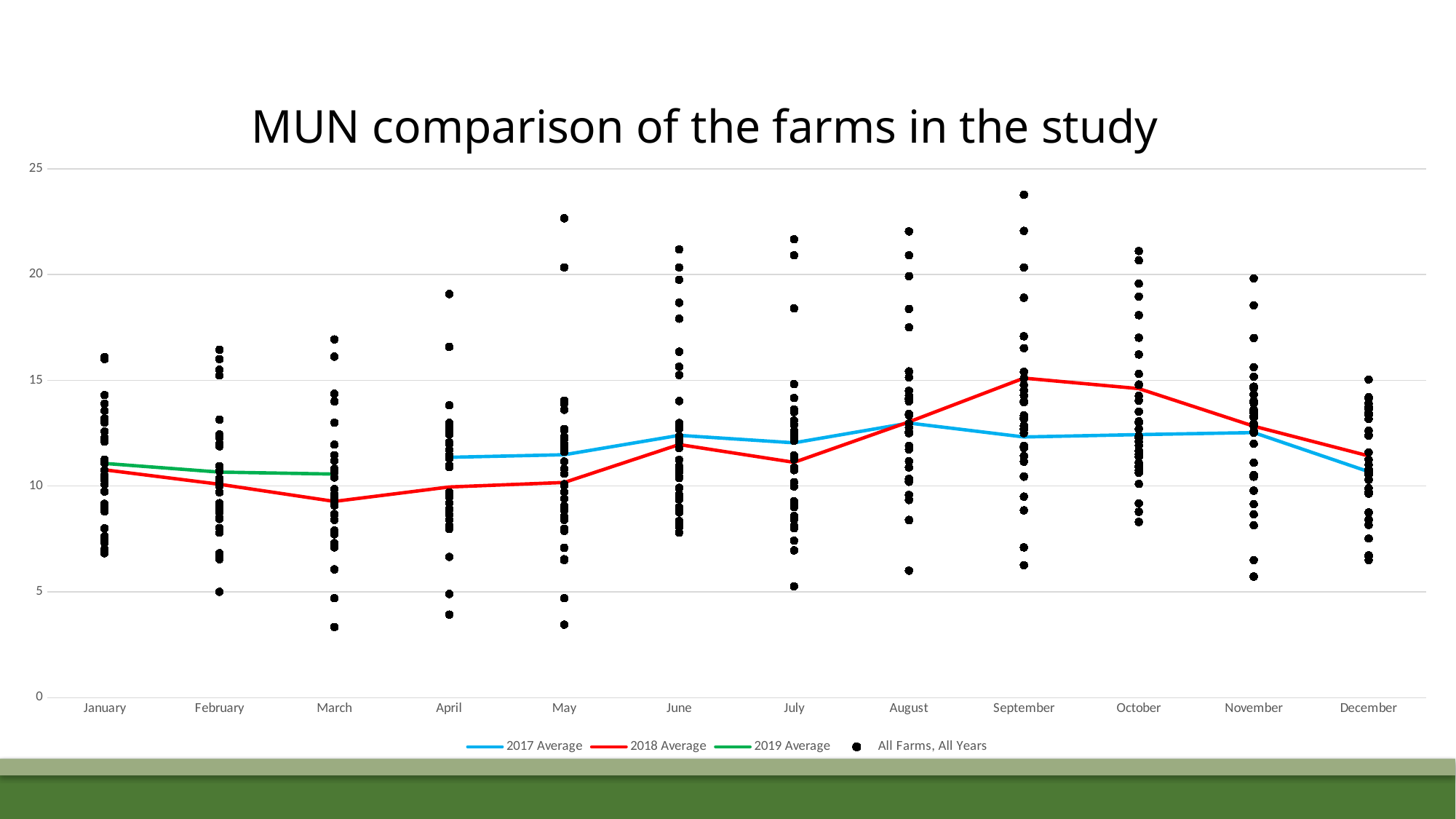
What is the title of the chart? MUN comparison of the farms in the study In May, which is higher: the 2017 Average or the 2018 Average? 2017 Average Is the 2018 Average for March greater or less than 10? less In September, which is higher: the 2017 Average or the 2018 Average? 2018 Average In which month is the 2018 Average lowest? March What kind of chart is shown on the slide? line chart Does the 2018 Average rise or fall from March to September? rise How many series does the legend list? 4 In which month is the 2018 Average highest? September Is the 2017 Average for June greater or less than 10? greater Is the 2019 Average for January greater or less than 10? greater How many months are shown on the x axis? 12